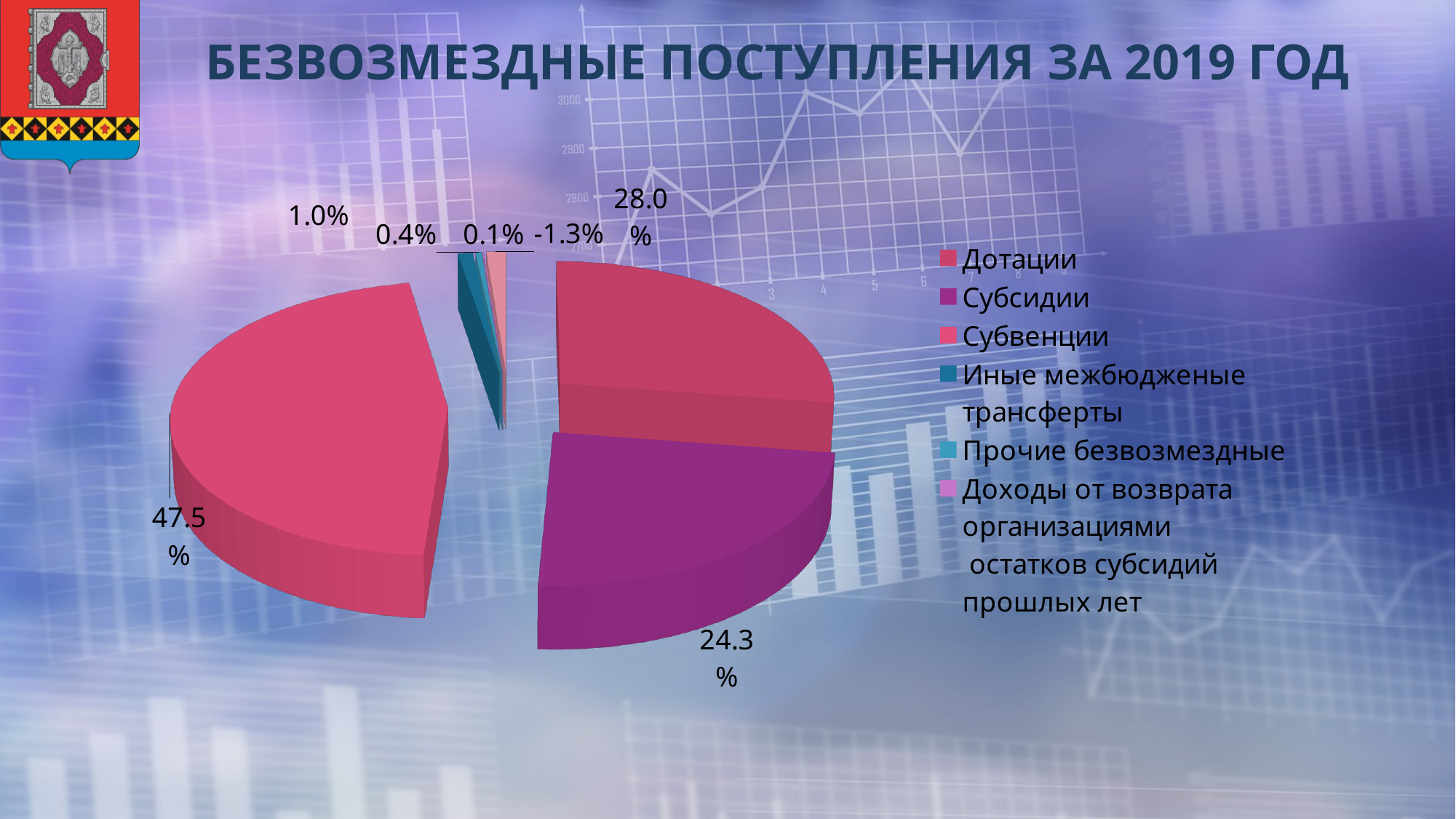
How many entries does the chart legend list? 6 What is the difference in percentage points between the slice labelled 28.0% and the slice labelled 24.3%? 3.7 What kind of chart is shown on the slide? pie chart What is the largest percentage label shown on the pie? 47.5% What share of the pie is labelled for Субсидии (the purple slice)? 24.3% How many percentage data labels are shown on the pie? 7 What is the title of the chart on the slide? БЕЗВОЗМЕЗДНЫЕ ПОСТУПЛЕНИЯ ЗА 2019 ГОД Which is larger, the slice labelled 28.0% or the Субсидии slice? the slice labelled 28.0% What is the smallest percentage label shown on the pie? -1.3% Which legend entry is shown with a teal (dark blue-green) colour? Иные межбюдженые трансферты What is the difference in percentage points between the largest slice (47.5%) and the Субсидии slice (24.3%)? 23.2 Is the share for Субсидии greater or less than 20%? greater